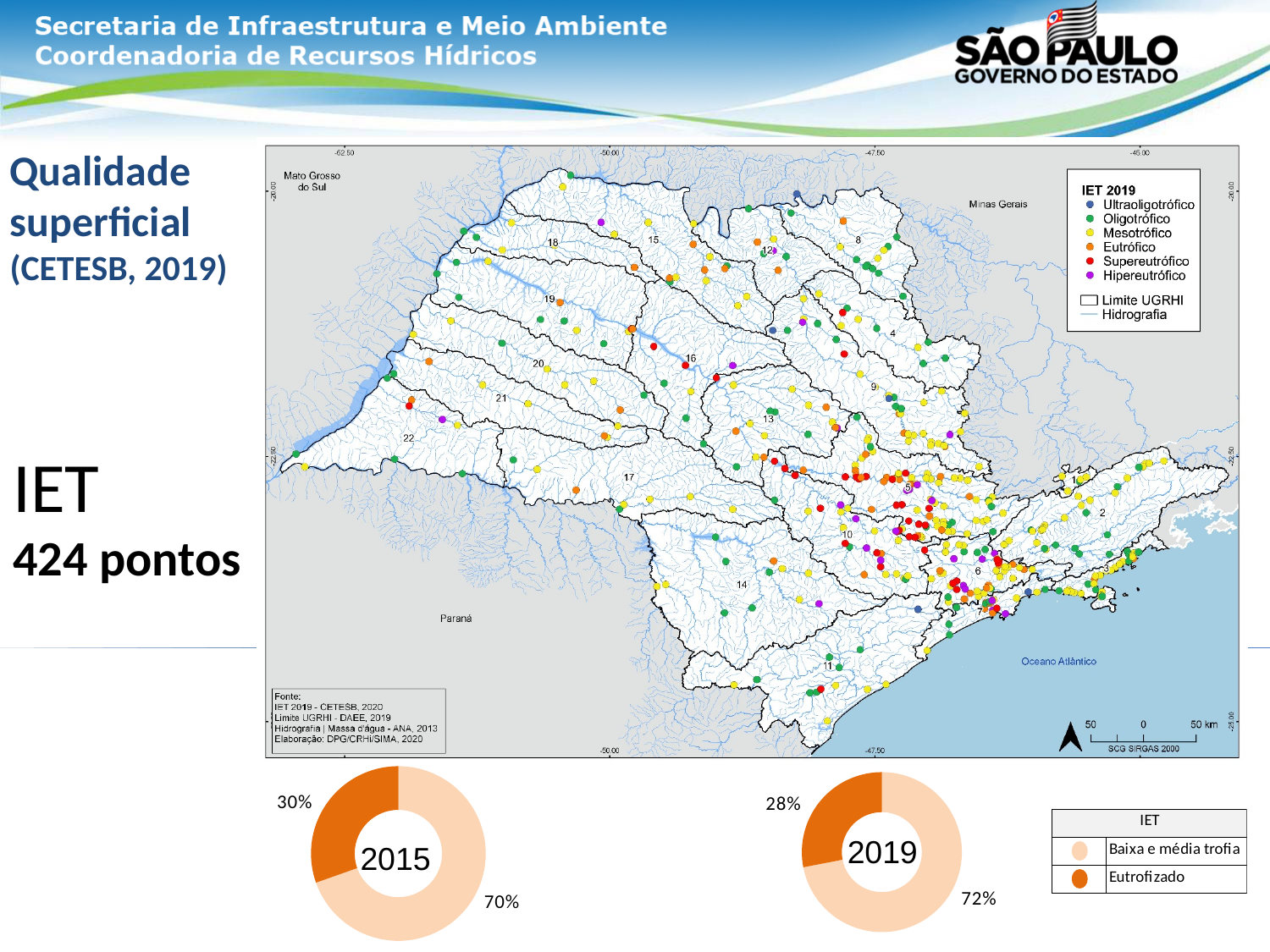
In the 2015 donut chart, what share is Baixa e média trofia? 70% In the 2019 donut chart, what share is Baixa e média trofia? 72% What is the difference between the Eutrofizado share in 2015 and in 2019? 2 percentage points In the 2019 donut chart, which category has the larger share? Baixa e média trofia Is the Eutrofizado share larger in the 2015 chart or the 2019 chart? 2015 In the 2015 donut chart, which category has the smaller share? Eutrofizado In the 2015 donut chart, what share is Eutrofizado? 30% How many categories does the IET legend list for the donut charts? 2 Which colour represents Eutrofizado in the donut charts? Dark orange In the 2019 donut chart, what share is Eutrofizado? 28% How many donut charts are shown on the slide? 2 What kind of chart is used to show the 2015 and 2019 IET shares? Donut (pie) chart